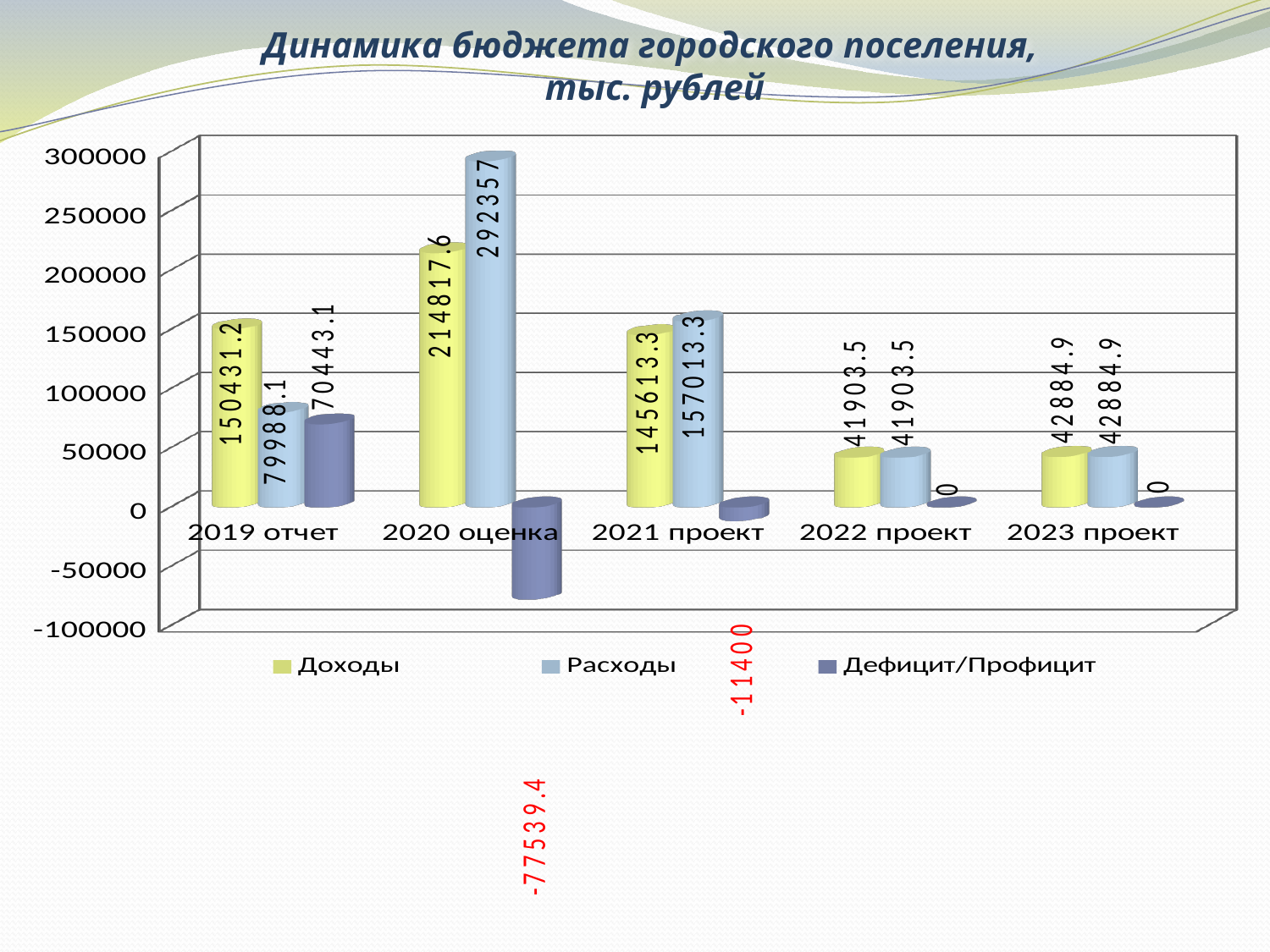
How many categories are shown on the x axis? 5 What is the value of Доходы for 2019 отчет? 150431.2 Which category has the lowest value of Дефицит/Профицит? 2020 оценка Is the value of Доходы for 2020 оценка greater or less than 200000? greater What kind of chart is shown on the slide? Bar chart Which is larger for 2019 отчет: Доходы or Расходы? Доходы What is the difference between Расходы and Доходы for 2021 проект? 11400 How many series does the legend list? 3 What is the value of Расходы for 2023 проект? 42884.9 What is the value of Дефицит/Профицит for 2021 проект? -11400 What is the value of Расходы for 2020 оценка? 292357 Which category has the highest value of Расходы? 2020 оценка